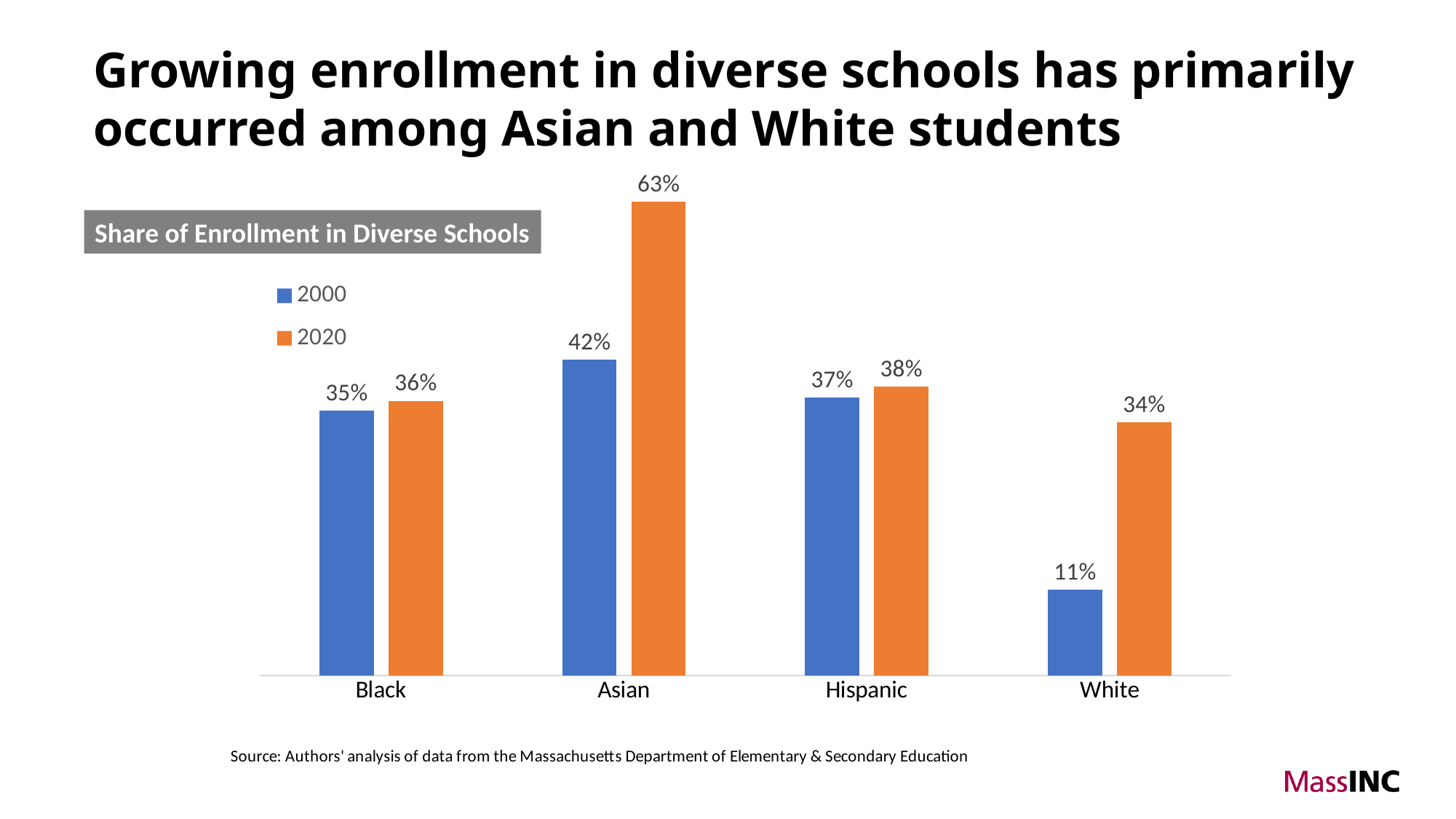
Which group had the highest share of enrollment in diverse schools in 2020? Asian Which group had the lowest share of enrollment in diverse schools in 2000? White By how many percentage points did the share of enrollment in diverse schools for White students increase from 2000 to 2020? 23 percentage points What type of chart is shown on the slide? Bar chart How many series does the legend list? 2 How many racial/ethnic groups are shown on the x axis of the chart? 4 What was the share of enrollment in diverse schools for Asian students in 2020? 63% What was the share of enrollment in diverse schools for Hispanic students in 2020? 38% By how many percentage points did the share of enrollment in diverse schools for Asian students increase from 2000 to 2020? 21 percentage points What was the share of enrollment in diverse schools for White students in 2000? 11% Which was larger in 2000: the share for Asian students or the share for Hispanic students? Asian What was the share of enrollment in diverse schools for Black students in 2000? 35%